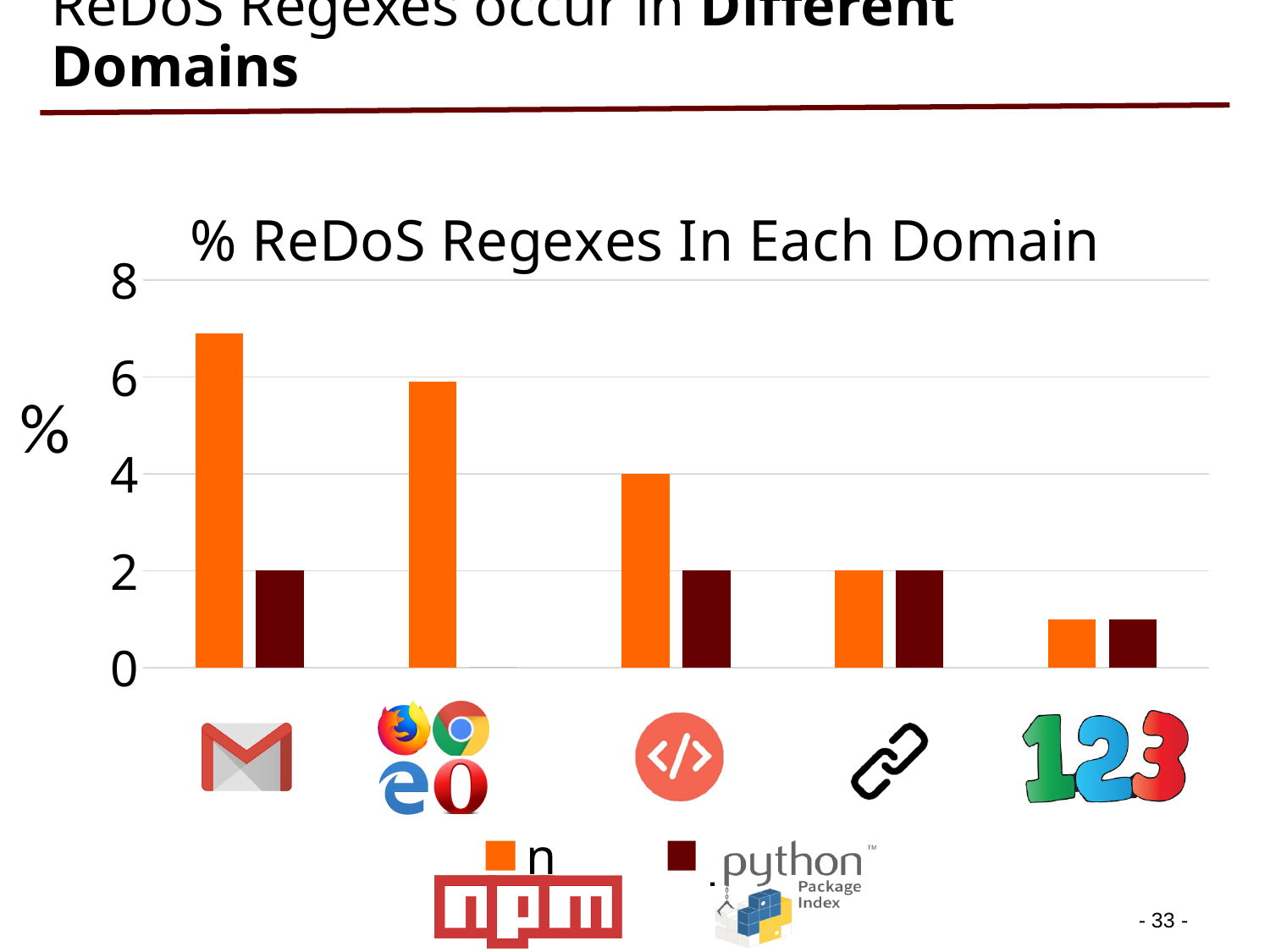
What is the value of the orange bar for the third category (code)? 4 Is the orange bar for the leftmost category (email) greater or less than 6? greater How many series does the chart's legend list? 2 What is the label on the vertical axis? % What is the value of the dark red bar for the leftmost category (email)? 2 What is the title of the chart? % ReDoS Regexes In Each Domain What kind of chart is shown on the slide? bar chart For the second category (browsers), which bar is larger, the orange one or the dark red one? the orange one How many categories (domains) are plotted along the x axis? 5 Which category has the highest orange bar? the leftmost category (email) Do the orange bars rise or fall from left to right across the categories? fall Is the orange bar for the second category (browsers) greater or less than 4? greater